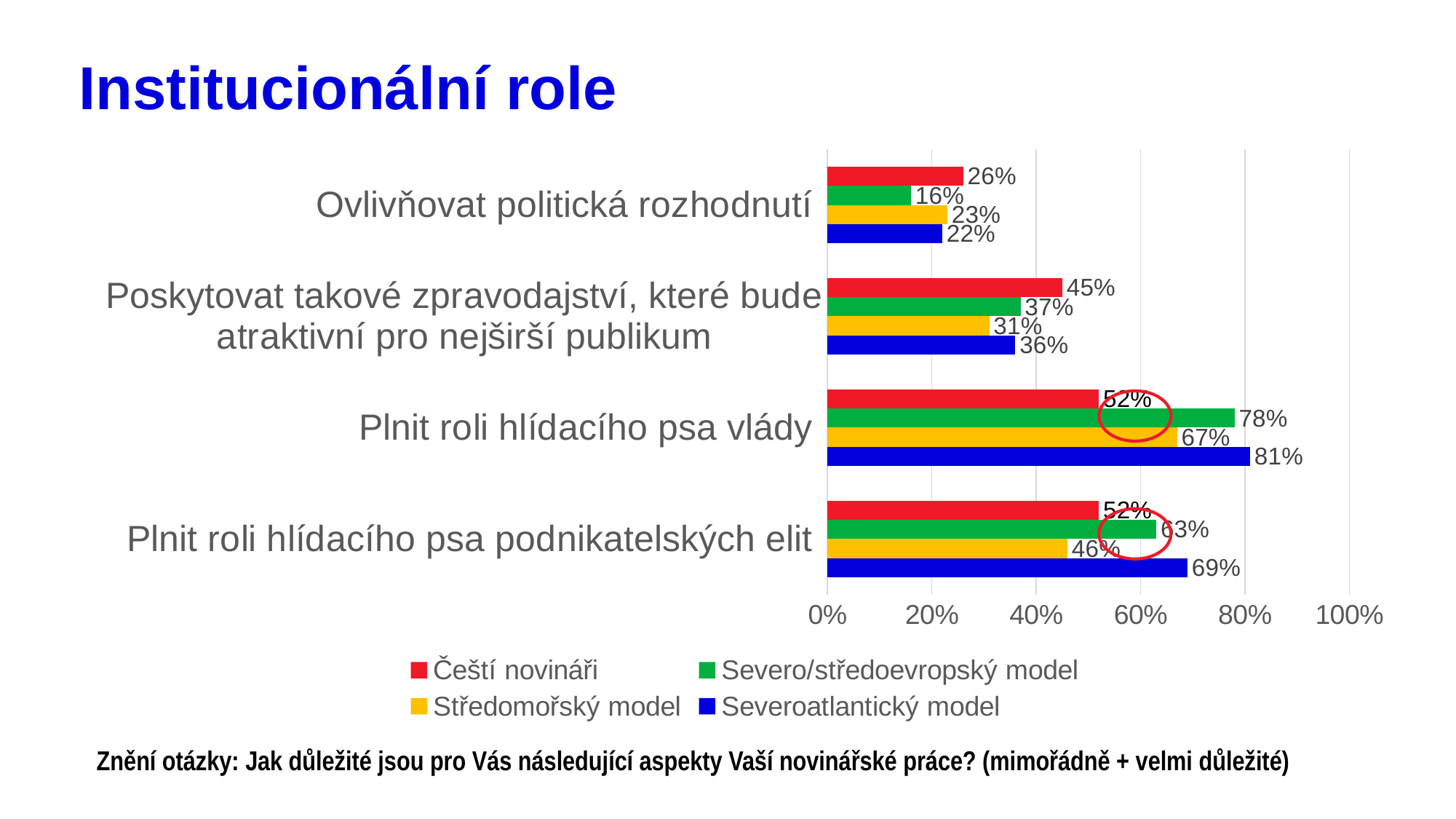
Which series has the highest value for 'Plnit roli hlídacího psa vlády'? Severoatlantický model What is the value for Severo/středoevropský model for 'Poskytovat takové zpravodajství, které bude atraktivní pro nejširší publikum'? 37% Which series has the lowest value for 'Ovlivňovat politická rozhodnutí'? Severo/středoevropský model What is the difference between the Severoatlantický model and Čeští novináři values for 'Plnit roli hlídacího psa podnikatelských elit'? 17% How many series does the legend list? 4 What is the value for Středomořský model for 'Plnit roli hlídacího psa podnikatelských elit'? 46% For 'Poskytovat takové zpravodajství, které bude atraktivní pro nejširší publikum', which is larger: Čeští novináři or Středomořský model? Čeští novináři Which series is shown in green in the legend? Severo/středoevropský model What is the value for Severoatlantický model for 'Plnit roli hlídacího psa vlády'? 81% What is the value for Čeští novináři for 'Ovlivňovat politická rozhodnutí'? 26% What kind of chart is shown on the slide? bar chart How many categories are shown on the chart? 4